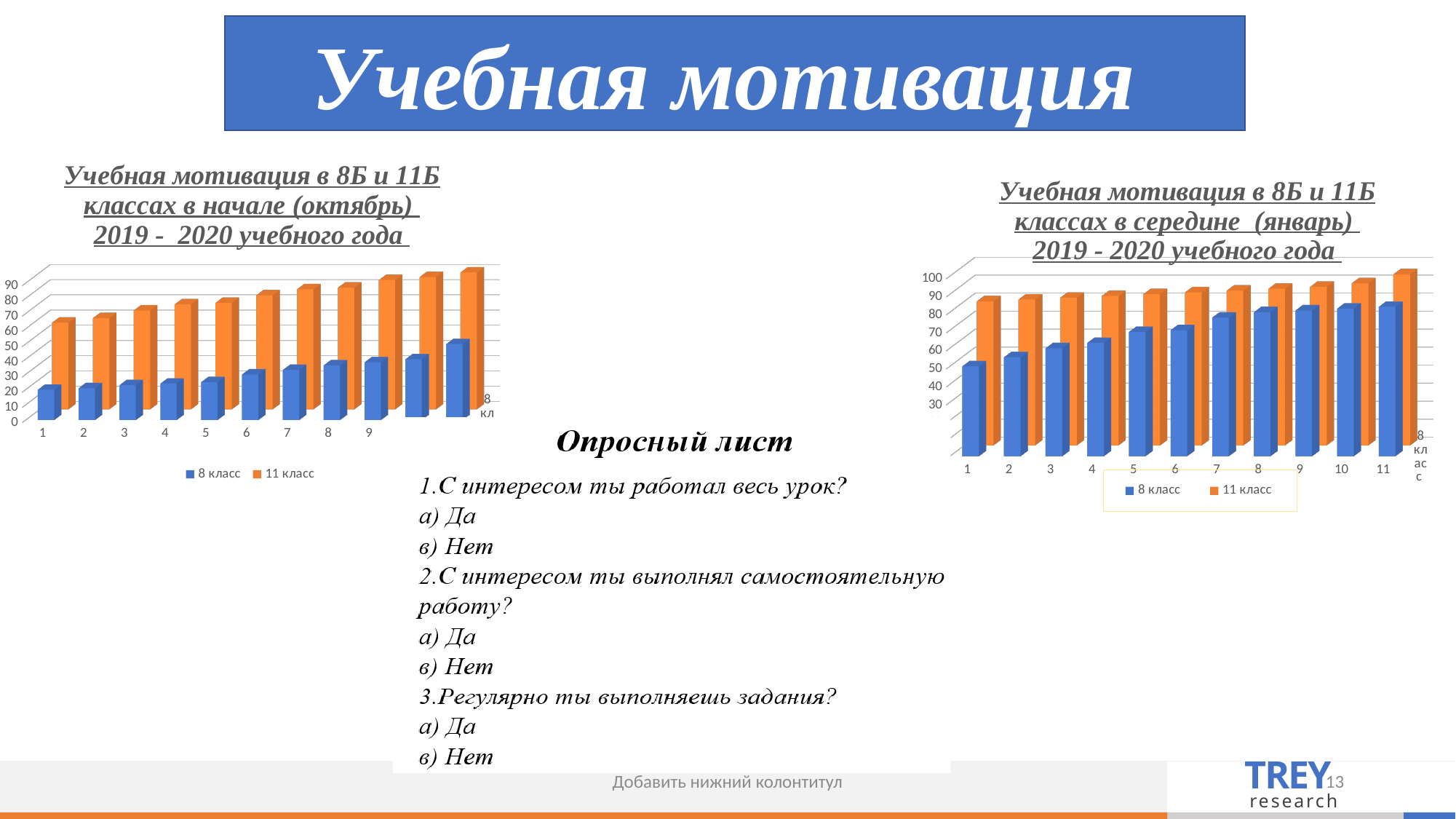
In the left chart (октябрь), do the values for 8 класс rise or fall along the x axis? Rise In the right chart (январь), which category has the lowest value for 8 класс? 1 What kind of chart is the left chart, 'Учебная мотивация в 8Б и 11Б классах в начале (октябрь) 2019 - 2020 учебного года'? Bar chart In the left chart (октябрь), is the value for 8 класс at category 1 greater or less than 30? less In the right chart (январь), is the value for 11 класс at category 11 greater or less than 90? greater In the right chart (январь), which category has the highest value for 8 класс? 11 In the left chart (октябрь), is the value for 11 класс at category 1 greater or less than 50? greater In the left chart (октябрь), which is larger at category 1: the value for 8 класс or for 11 класс? 11 класс How many series does the legend of the right chart, 'Учебная мотивация в 8Б и 11Б классах в середине (январь) 2019 - 2020 учебного года', list? 2 In the right chart (январь), do the values for 11 класс rise or fall along the x axis? Rise In the right chart (январь), which series is shown in orange? 11 класс In the right chart (январь), how many categories are shown on the x axis? 11